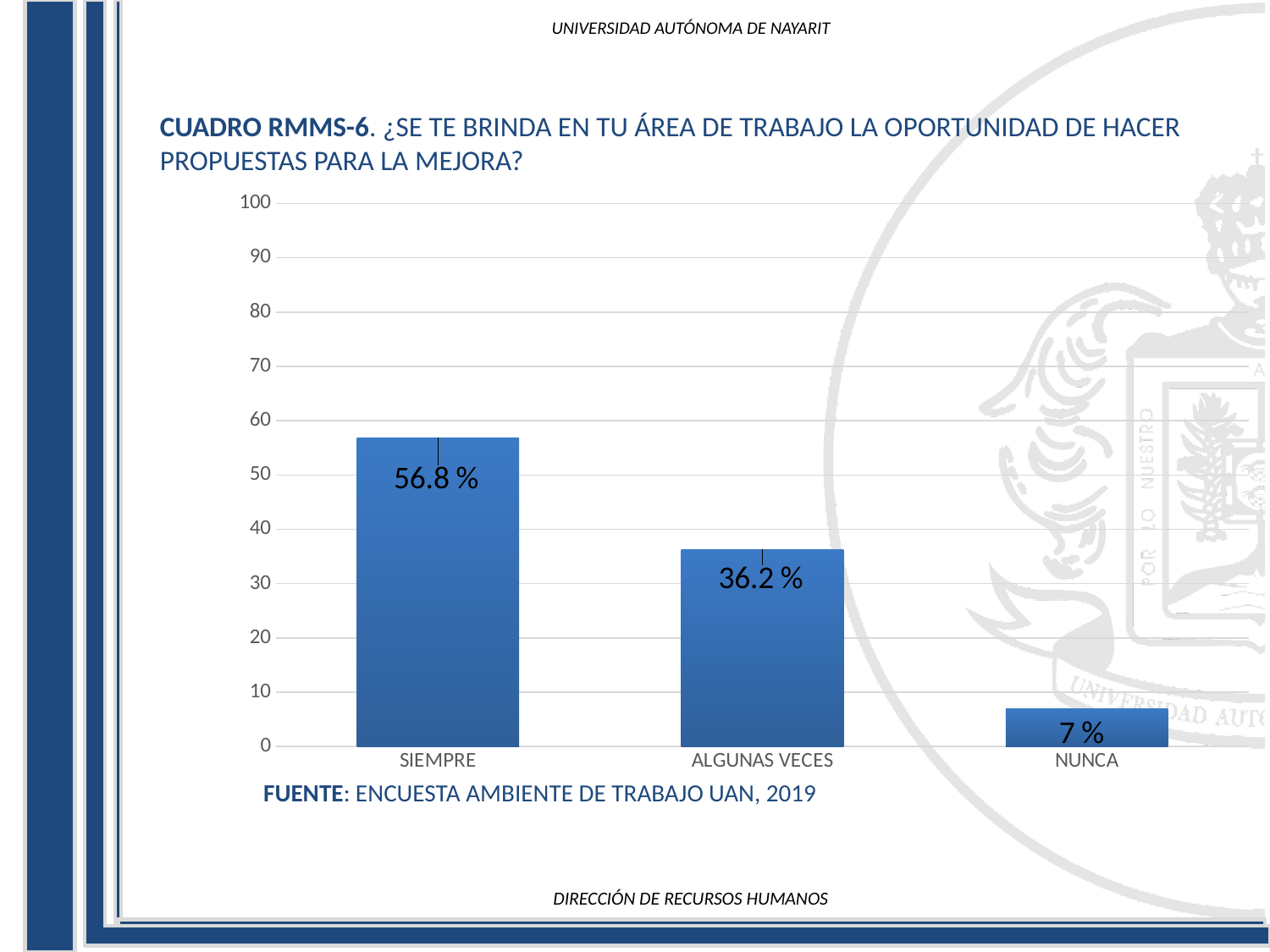
What is the difference between the values for ALGUNAS VECES and NUNCA? 29.2 % What is the value for ALGUNAS VECES? 36.2 % What is the value for NUNCA? 7 % What is the value for SIEMPRE? 56.8 % Which category has the highest value? SIEMPRE Do the values rise or fall from left to right along the x axis? fall Is the value for SIEMPRE greater or less than 50? greater What kind of chart is shown on the slide? bar chart How many categories are shown on the x axis? 3 What is the difference between the values for SIEMPRE and ALGUNAS VECES? 20.6 % Which category has the lowest value? NUNCA Which is larger, the value for ALGUNAS VECES or the value for NUNCA? ALGUNAS VECES